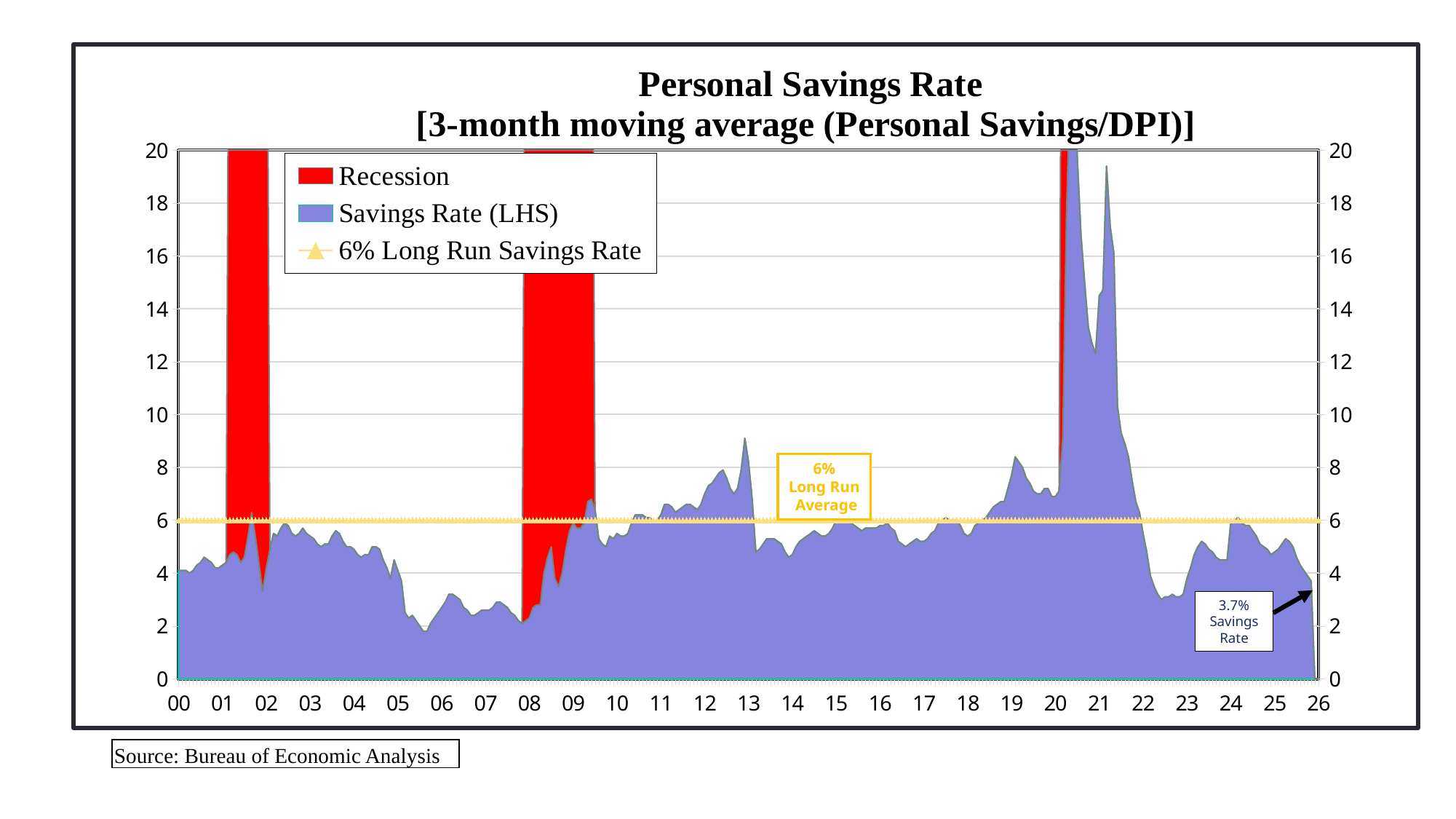
What is the source cited for the chart? Bureau of Economic Analysis Which is higher, the savings rate in 2019 or in 2006? 2019 Is the savings rate in 2006 greater or less than 4? less How many entries does the legend list? 3 What is the long run savings rate shown by the horizontal line? 6% Between 2021 and 2022, does the savings rate rise or fall? fall Is the savings rate peak in 2020 greater or less than 18? greater Is the savings rate spike at the start of 2013 greater or less than 8? greater In which year does the savings rate reach its highest peak? 2020 What is the most recent savings rate value annotated on the chart? 3.7% What kind of chart is shown on the slide? area chart How many recession periods are shaded in red on the chart? 3